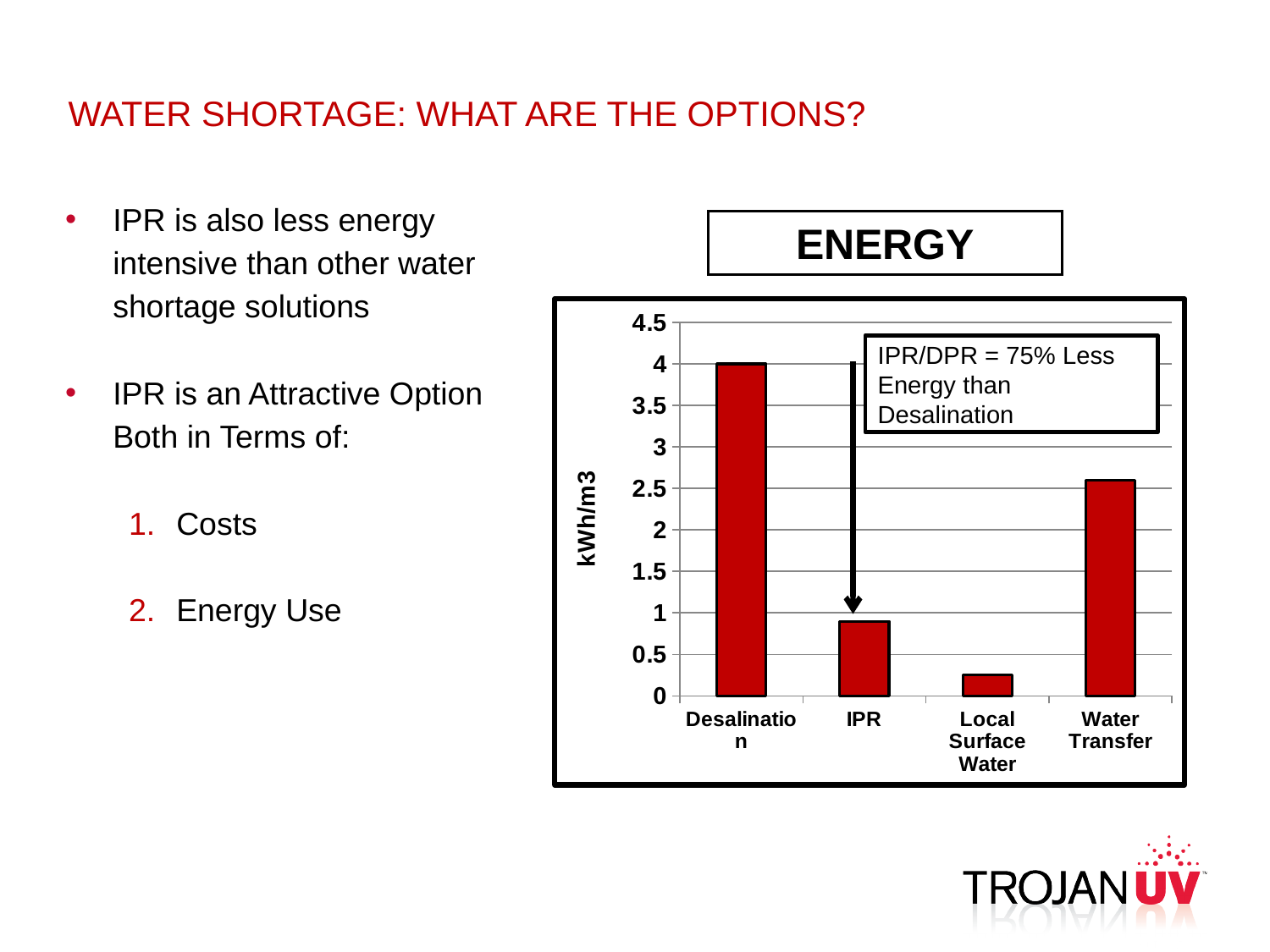
What unit is shown on the y-axis of the ENERGY chart? kWh/m3 How many categories are plotted in the ENERGY chart? 4 Which has a larger energy value in the ENERGY chart, IPR or Water Transfer? Water Transfer Is the value for IPR greater or less than 1 in the ENERGY chart? less Which category has the lowest energy value in the ENERGY chart? Local Surface Water Which has a larger energy value in the ENERGY chart, Desalination or Water Transfer? Desalination What type of chart is shown under the ENERGY title? bar chart Which category has the highest energy value in the ENERGY chart? Desalination What is the energy value for Desalination in the ENERGY chart? 4 Is the value for Water Transfer greater or less than 2.5 in the ENERGY chart? greater Is the value for Local Surface Water greater or less than 0.5 in the ENERGY chart? less According to the annotation on the ENERGY chart, how much less energy does IPR/DPR use than Desalination? 75% Less